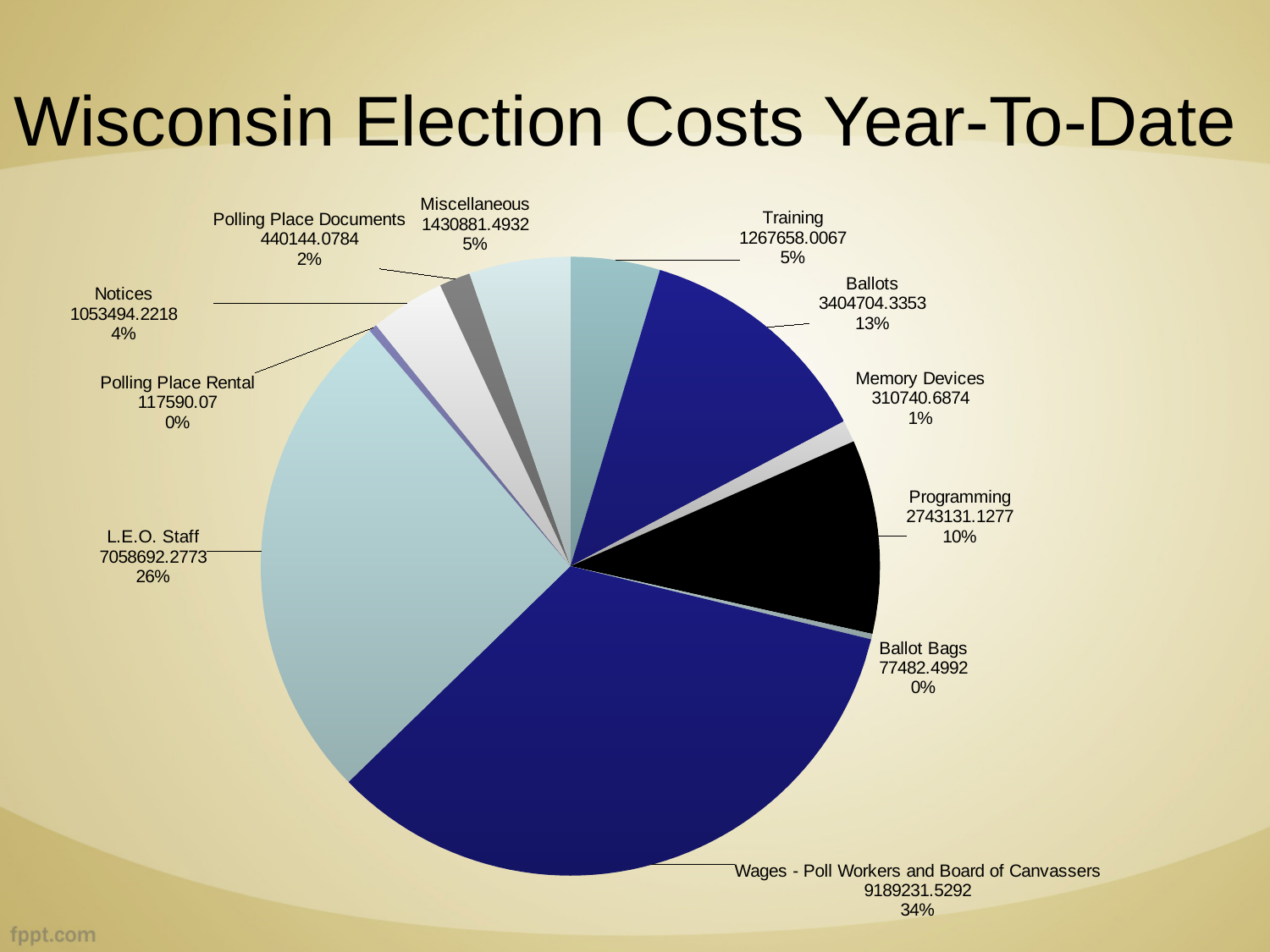
How many categories (slices) does the pie chart have? 11 What is the title of the chart? Wisconsin Election Costs Year-To-Date What is the value shown for L.E.O. Staff? 7058692.2773 What kind of chart is shown on the slide? Pie chart Which category has the smallest value? Ballot Bags Which is larger, the value for Training or the value for Miscellaneous? Miscellaneous What percentage share of the pie does Wages - Poll Workers and Board of Canvassers have? 34% Which category has the largest share of the pie? Wages - Poll Workers and Board of Canvassers What is the value shown for Programming? 2743131.1277 What is the value shown for Polling Place Rental? 117590.07 What percentage share of the pie does Notices have? 4% What is the value shown for Ballots? 3404704.3353